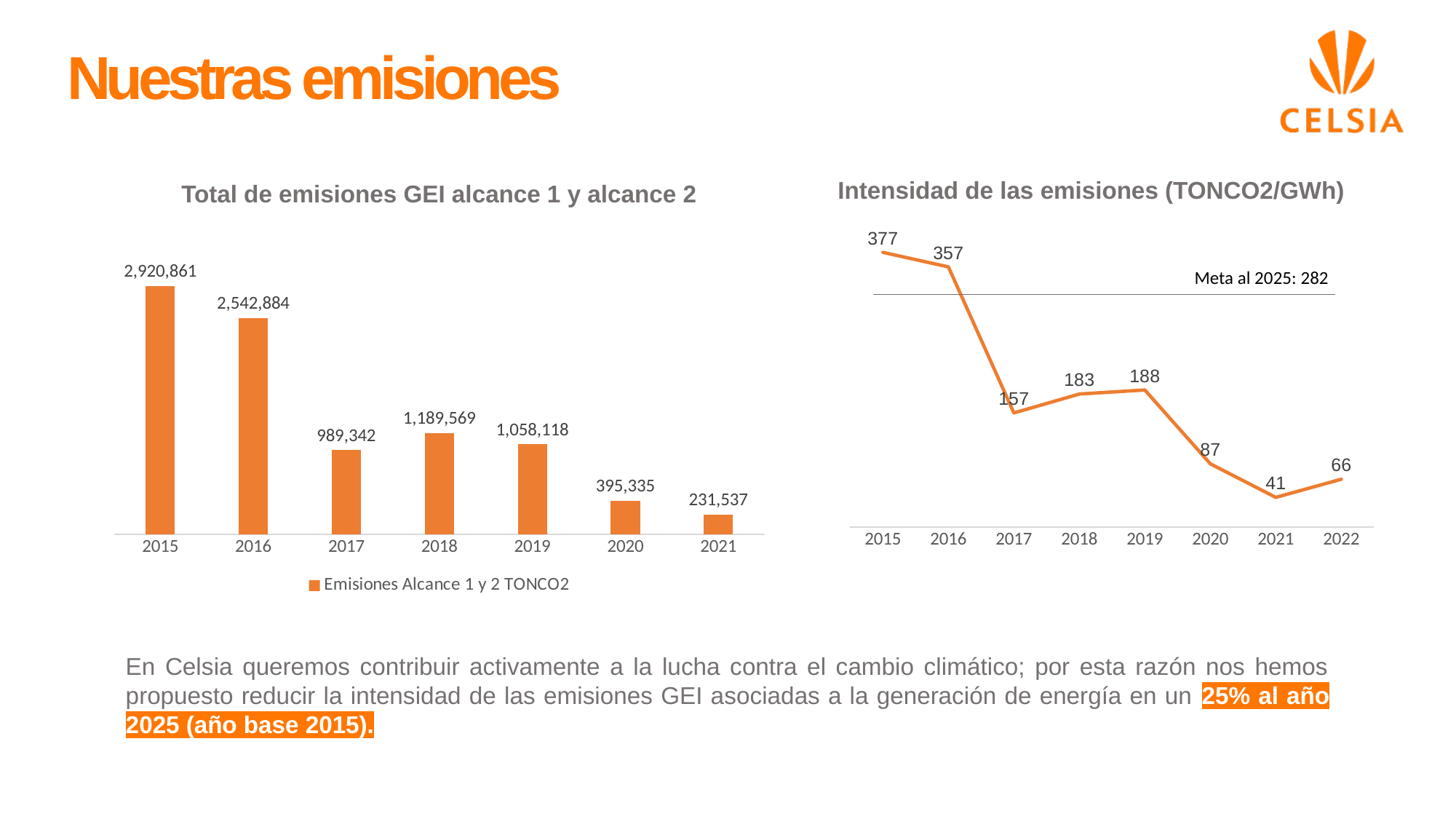
In the 'Intensidad de las emisiones (TONCO2/GWh)' chart, what is the value for 2017? 157 In the 'Total de emisiones GEI alcance 1 y alcance 2' chart, what is the value for 2021? 231,537 In the 'Intensidad de las emisiones (TONCO2/GWh)' chart, what is the value for 2022? 66 In the 'Intensidad de las emisiones (TONCO2/GWh)' chart, is the value for 2018 or 2019 larger? 2019 In the 'Intensidad de las emisiones (TONCO2/GWh)' chart, which year has the lowest value? 2021 In the 'Total de emisiones GEI alcance 1 y alcance 2' chart, what is the difference between the 2018 and 2019 values? 131,451 In the 'Total de emisiones GEI alcance 1 y alcance 2' chart, what is the value for 2015? 2,920,861 In the 'Intensidad de las emisiones (TONCO2/GWh)' chart, what is the target value labelled 'Meta al 2025'? 282 In the 'Total de emisiones GEI alcance 1 y alcance 2' chart, how many years are shown? 7 In the 'Total de emisiones GEI alcance 1 y alcance 2' chart, which year has the highest emissions? 2015 In the 'Total de emisiones GEI alcance 1 y alcance 2' chart, which year has the lowest emissions? 2021 What kind of chart is 'Total de emisiones GEI alcance 1 y alcance 2'? Bar chart